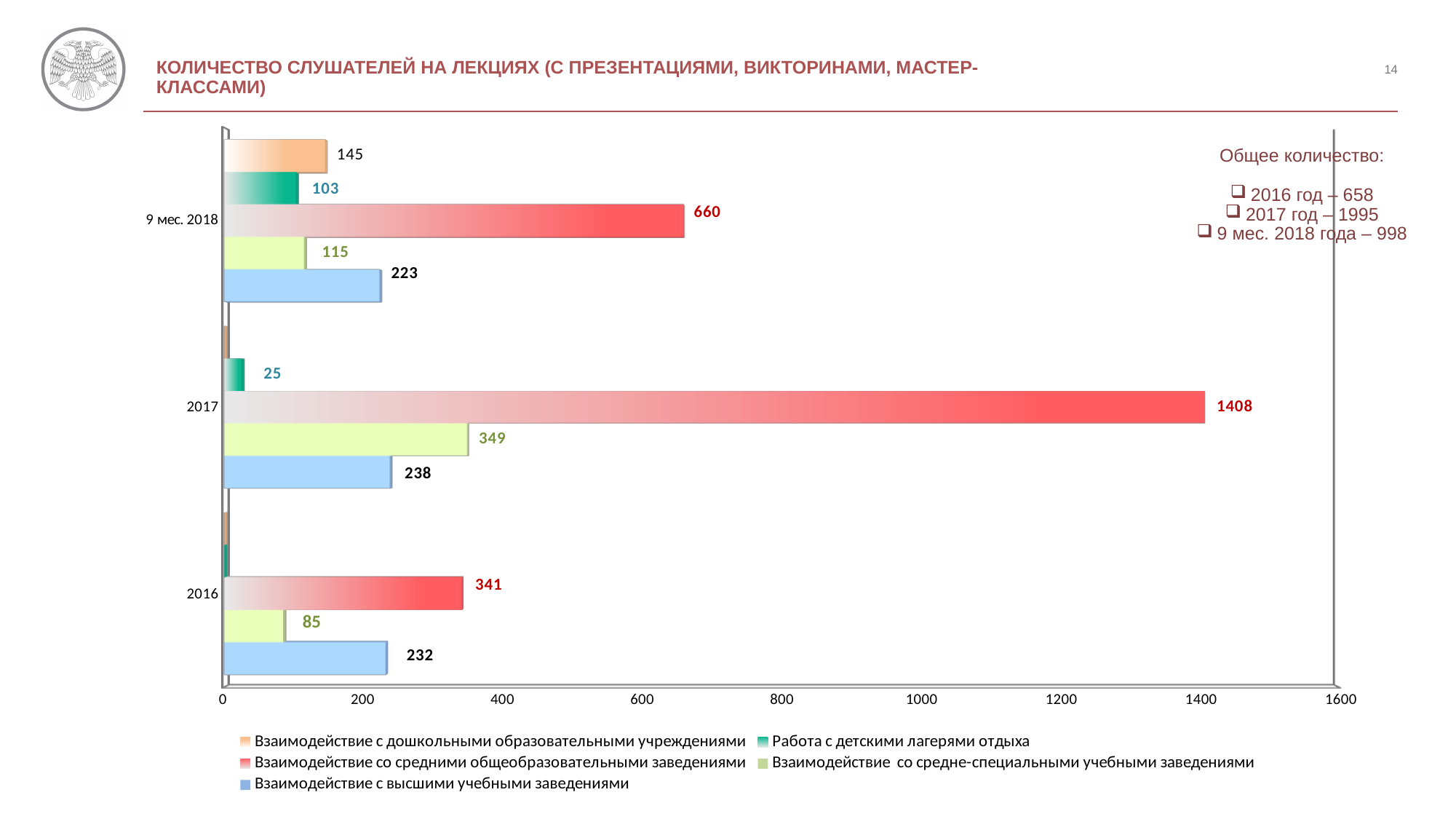
What is the value for 'Работа с детскими лагерями отдыха' for 9 мес. 2018? 103 What is the difference between the 2017 and 2016 values for 'Взаимодействие со средними общеобразовательными заведениями'? 1067 Which period has the lowest value for 'Взаимодействие со средне-специальными учебными заведениями'? 2016 How many categories (periods) are shown on the vertical axis? 3 What is the value for 'Взаимодействие со средними общеобразовательными заведениями' in 2017? 1408 What is the value for 'Взаимодействие с дошкольными образовательными учреждениями' for 9 мес. 2018? 145 How many series does the legend list? 5 Which is larger: the 2017 value for 'Взаимодействие со средне-специальными учебными заведениями' or the 2017 value for 'Взаимодействие с высшими учебными заведениями'? Взаимодействие со средне-специальными учебными заведениями Is the 2017 value for 'Взаимодействие со средними общеобразовательными заведениями' greater or less than 1200? greater What type of chart is shown on the slide? bar chart What is the value for 'Взаимодействие с высшими учебными заведениями' in 2016? 232 Which period has the highest value for 'Взаимодействие со средними общеобразовательными заведениями'? 2017